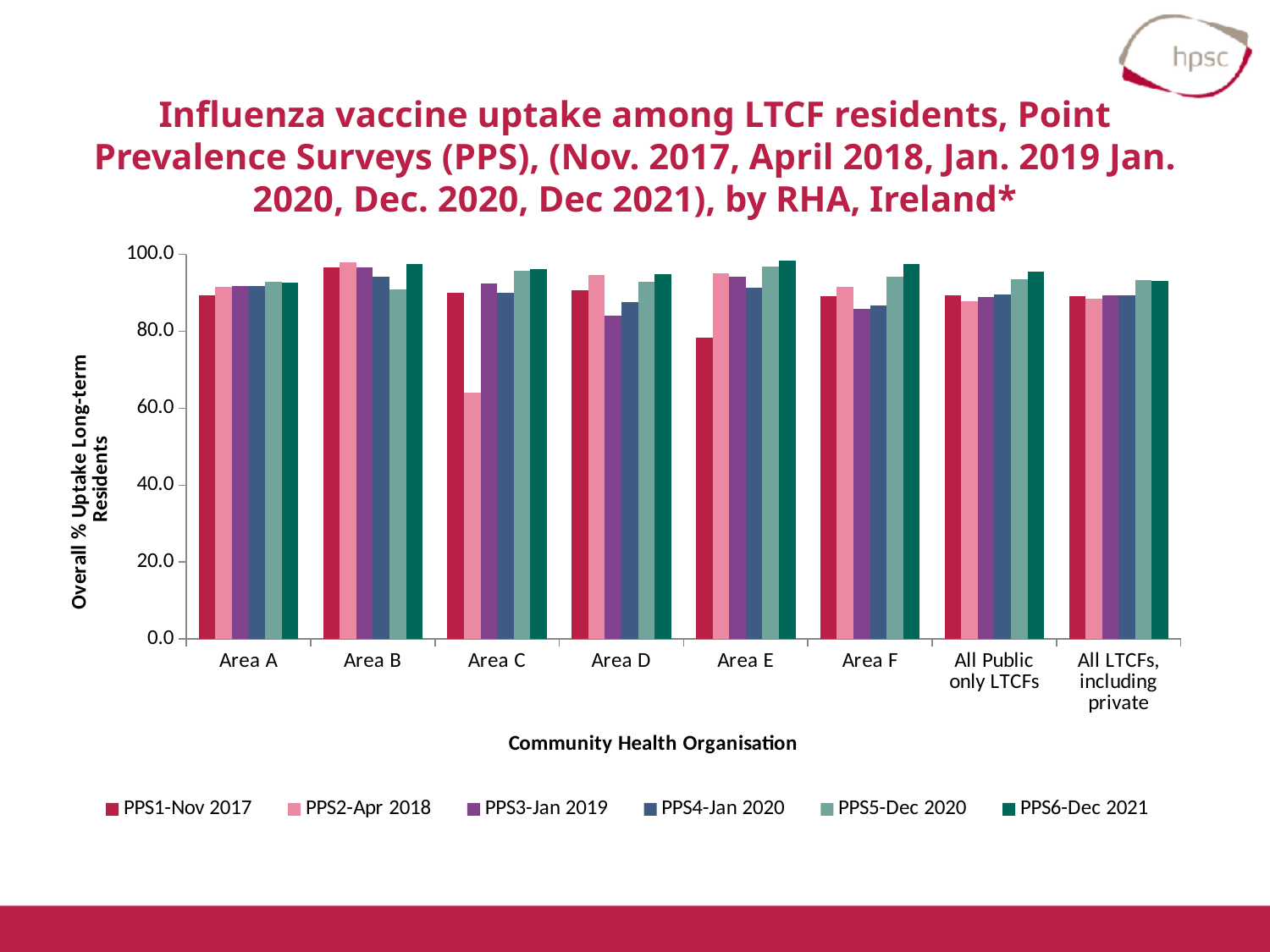
In Area E, which is larger: PPS1-Nov 2017 or PPS6-Dec 2021? PPS6-Dec 2021 How many series does the legend list? 6 Within Area E, which series has the lowest value? PPS1-Nov 2017 What is the title of the x axis? Community Health Organisation Is the value for PPS2-Apr 2018 in Area C greater or less than 80? less Is the value for PPS1-Nov 2017 in Area E greater or less than 80? less What kind of chart is shown on the slide? bar chart Which category has the lowest value for PPS2-Apr 2018? Area C Is the value for PPS2-Apr 2018 in Area B greater or less than 90? greater How many categories are shown on the x axis? 8 Which category has the lowest value for PPS1-Nov 2017? Area E In Area C, which is larger: PPS2-Apr 2018 or PPS5-Dec 2020? PPS5-Dec 2020